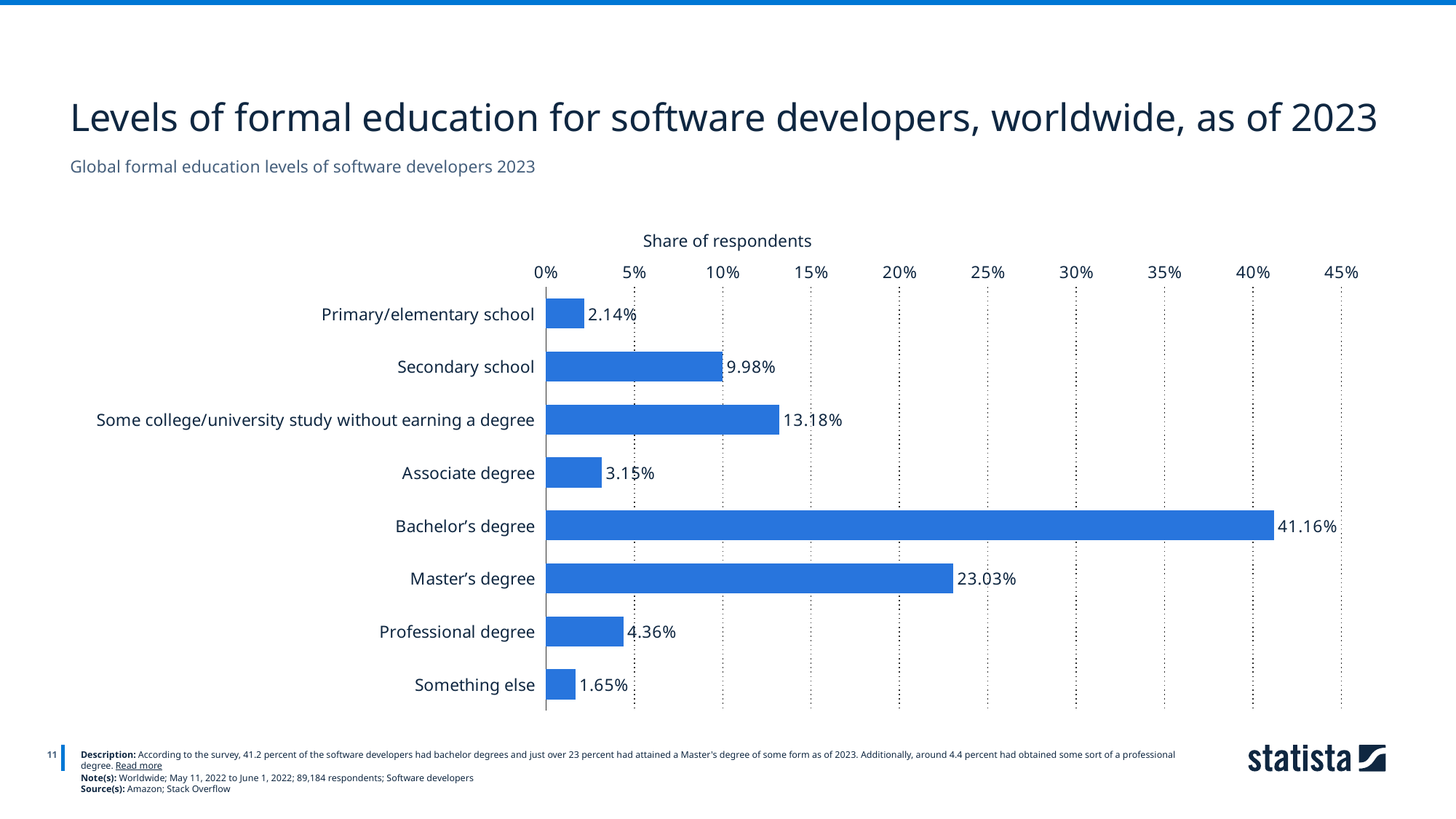
Which is larger, the share for Associate degree or the share for Professional degree? Professional degree What is the label of the horizontal axis? Share of respondents What share of respondents have a Bachelor's degree? 41.16% What share of respondents reported Some college/university study without earning a degree? 13.18% What is the difference between the shares for Bachelor's degree and Master's degree? 18.13% Which education level has the highest share of respondents? Bachelor's degree What is the value for Secondary school? 9.98% Which education level has the lowest share of respondents? Something else Is the value for Master's degree greater or less than 20%? greater What kind of chart is shown on the slide? Bar chart How many education level categories are shown in the chart? 8 What is the value for Professional degree? 4.36%